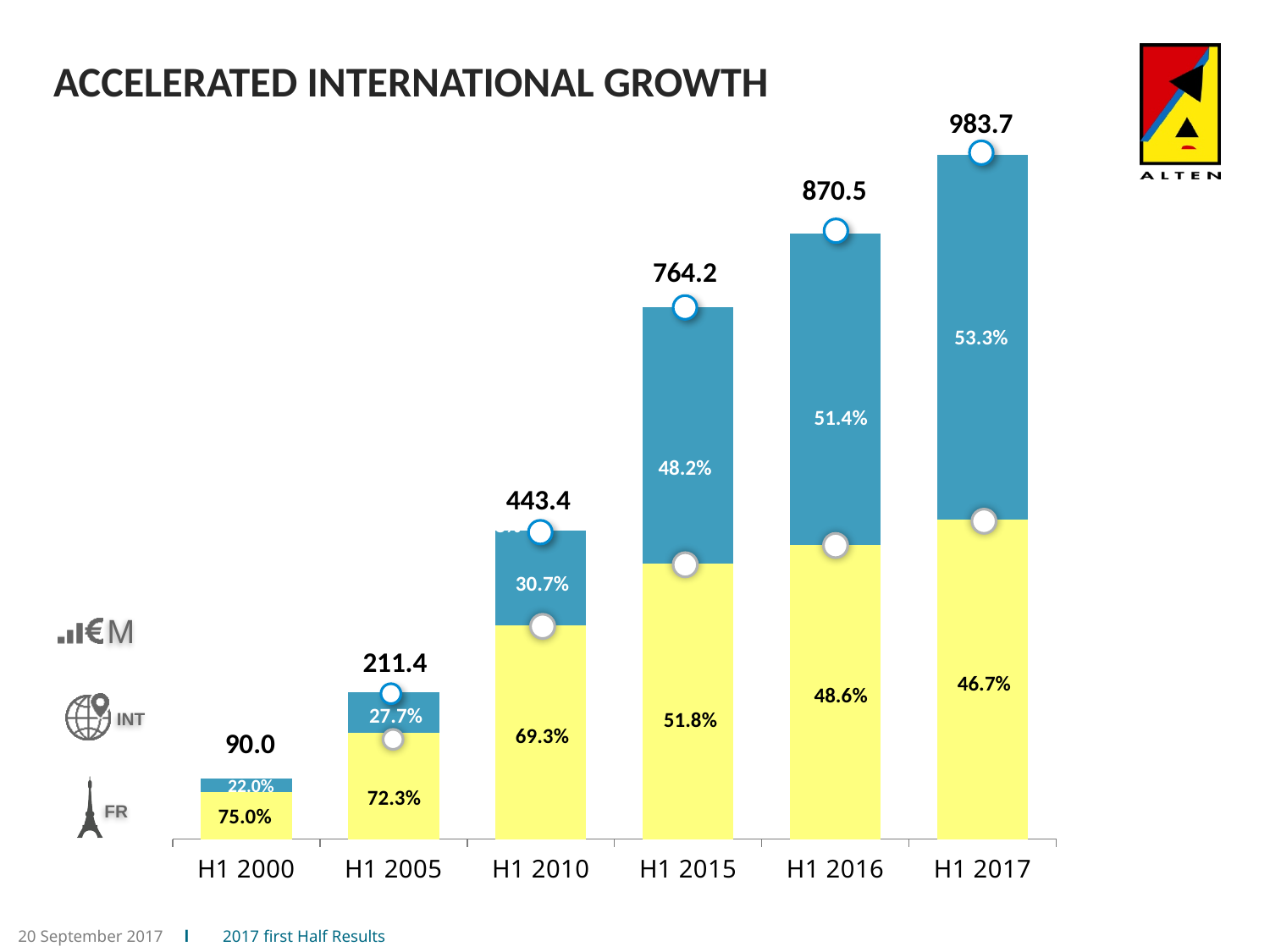
What percentage share does INT (international) have in H1 2015? 48.2% Which period has the lowest total value? H1 2000 What kind of chart is shown on the slide? Stacked bar chart What is the total value shown for H1 2000? 90.0 What percentage share does INT have in H1 2005? 27.7% How many periods are shown on the x axis? 6 Do the total values rise or fall from H1 2000 to H1 2017? Rise Which period has the highest total value? H1 2017 What is the total value shown for H1 2017? 983.7 What percentage share does FR (France) have in H1 2010? 69.3% What is the difference between the total values for H1 2017 and H1 2016? 113.2 In H1 2016, which share is larger, INT or FR? INT